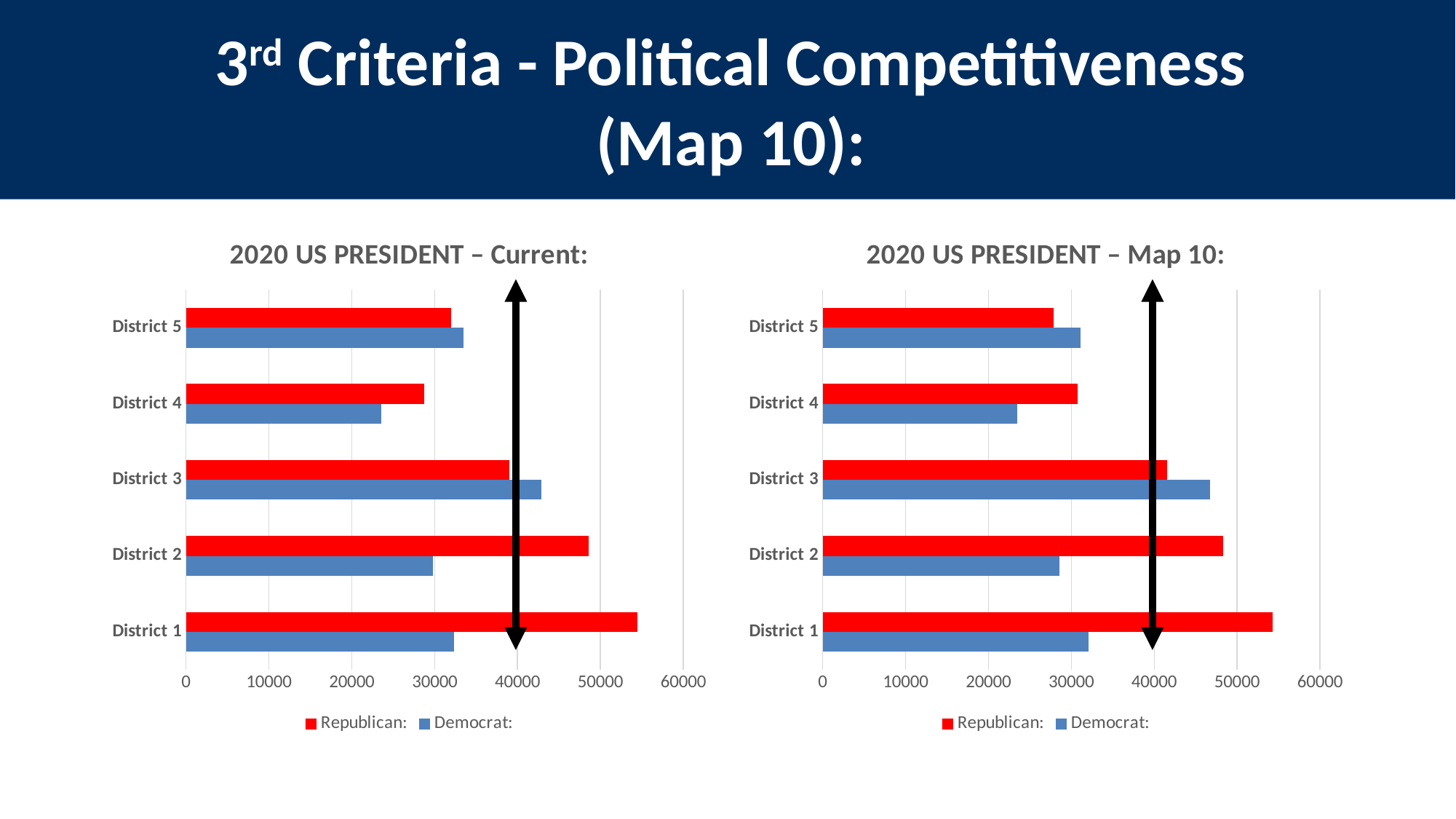
How many series does the legend of the "2020 US PRESIDENT – Current:" chart list? 2 What kind of chart is the "2020 US PRESIDENT – Current:" chart? Bar chart On the "2020 US PRESIDENT – Map 10:" chart, is the Democrat value for District 4 greater or less than 30000? less On the "2020 US PRESIDENT – Current:" chart, which district has the lowest Democrat value? District 4 What are the two legend entries on the "2020 US PRESIDENT – Map 10:" chart? Republican and Democrat On the "2020 US PRESIDENT – Current:" chart, is the Republican value for District 1 greater or less than 50000? greater On the "2020 US PRESIDENT – Map 10:" chart, which is larger for District 4, the Republican or the Democrat value? Republican On the "2020 US PRESIDENT – Current:" chart, which is larger for District 2, the Republican or the Democrat value? Republican On the "2020 US PRESIDENT – Map 10:" chart, which district has the highest Democrat value? District 3 How many districts are shown on the "2020 US PRESIDENT – Map 10:" chart? 5 On the "2020 US PRESIDENT – Current:" chart, which district has the highest Republican value? District 1 On the "2020 US PRESIDENT – Map 10:" chart, is the Democrat value for District 3 greater or less than 40000? greater